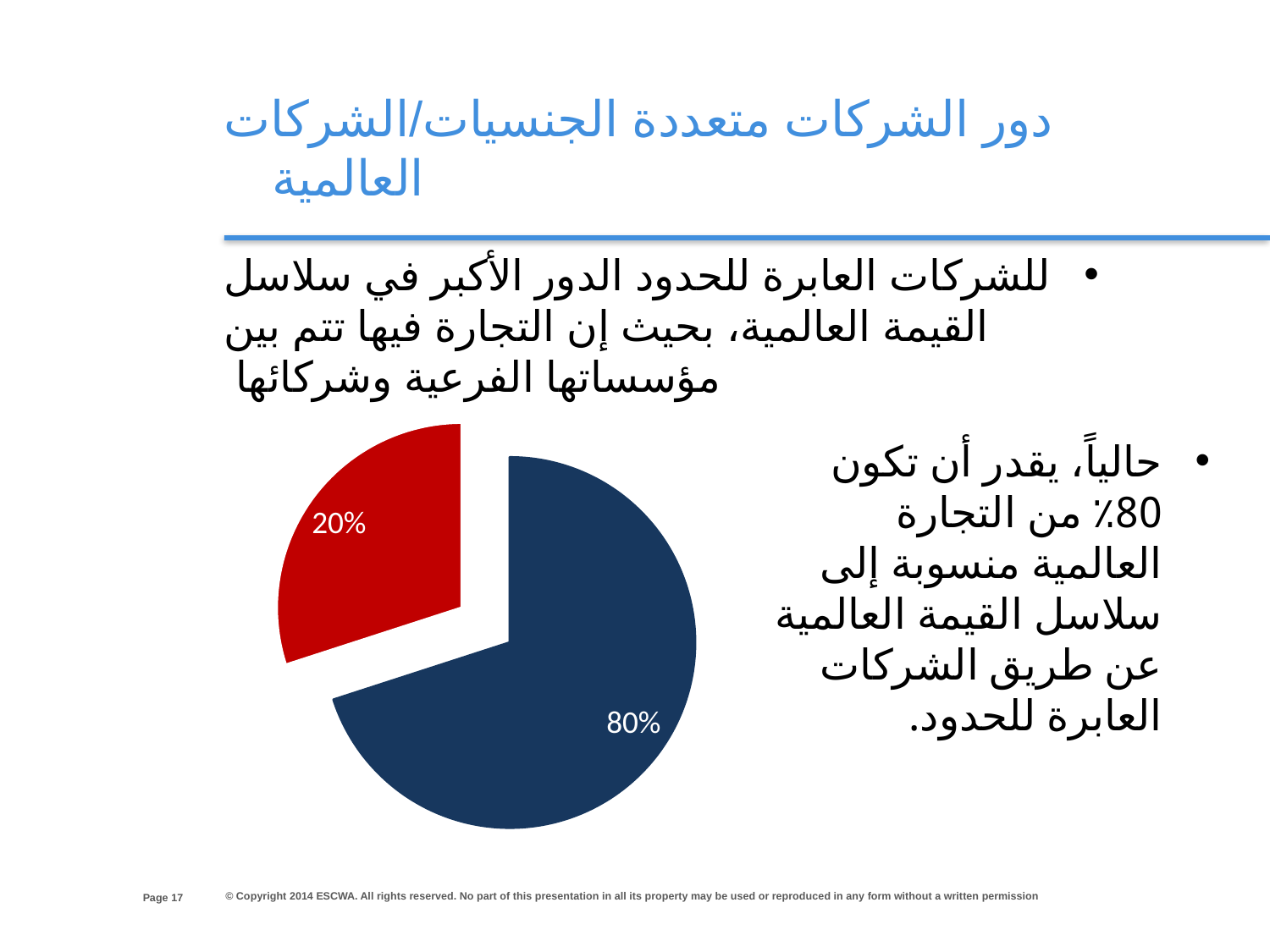
What value is labelled on the red slice of the pie chart? 20% Which is larger in the pie chart, the red slice or the dark blue slice? the dark blue slice Which slice of the pie chart is the largest? the dark blue slice (80%) What kind of chart is shown on the slide? pie chart Which slice of the pie chart is pulled out (exploded) from the rest of the pie? the red slice (20%) What share of the pie does the dark blue slice represent? 80% What value is labelled on the dark blue slice of the pie chart? 80% Which slice of the pie chart is the smallest? the red slice (20%) What colour is the slice labelled 80% in the pie chart? dark blue What is the difference in percentage points between the two slices of the pie chart? 60 What share of the pie does the red slice represent? 20% How many slices does the pie chart have? 2